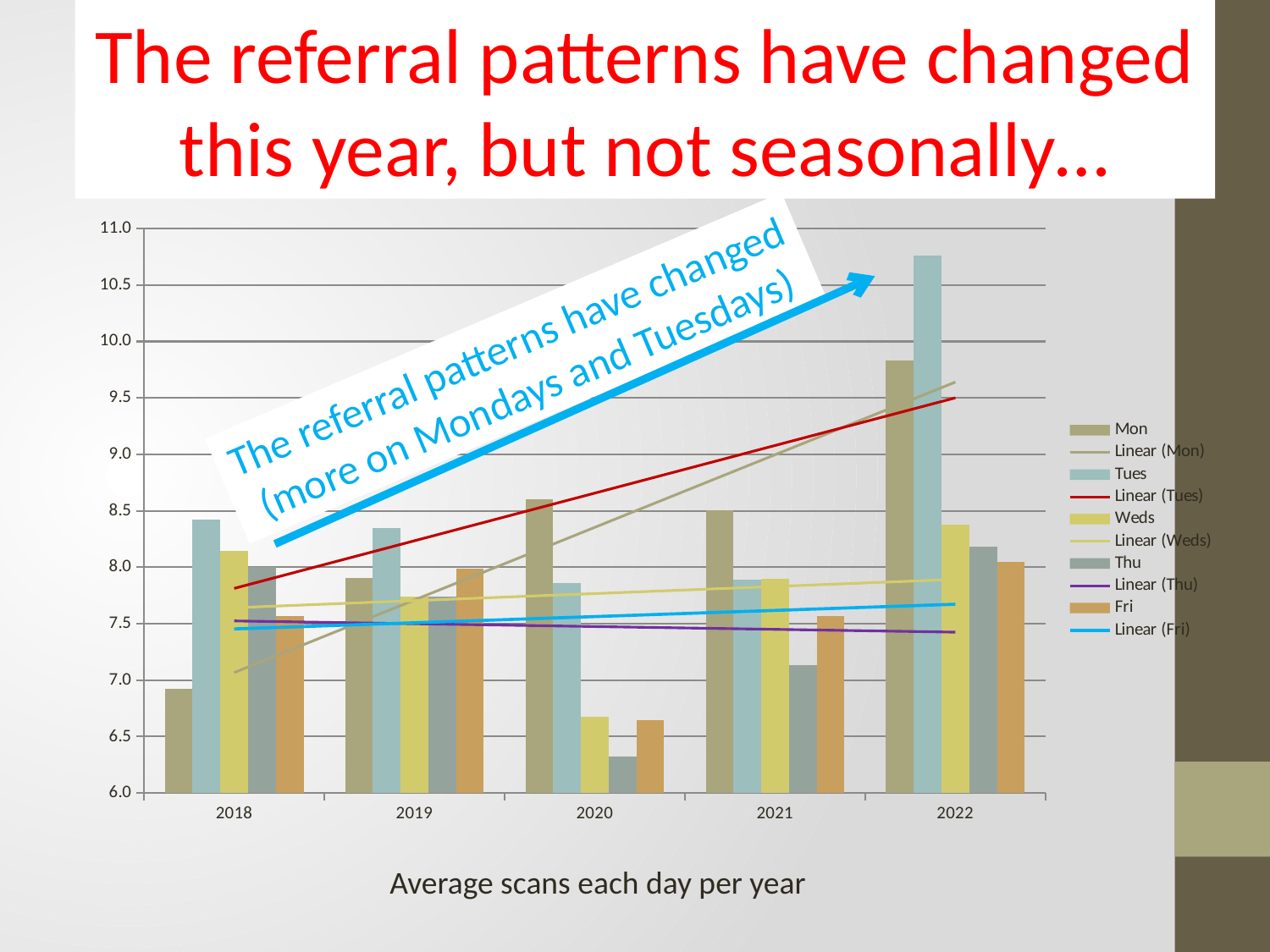
Is the value for Mon in 2018 greater or less than 7.0? less What kind of chart is shown on the slide? Bar chart (with linear trend lines) Which bar is the highest in the whole chart? Tues in 2022 Is the value for Tues in 2022 greater or less than 10.5? greater How many entries does the chart's legend list? 10 What caption appears below the chart? Average scans each day per year In 2020, which is larger, the Mon bar or the Weds bar? Mon Does the Linear (Mon) trend line rise or fall from 2018 to 2022? rise Is the value for Thu in 2020 greater or less than 6.5? less Which bar is the lowest in the whole chart? Thu in 2020 How many years are shown along the x axis of the chart? 5